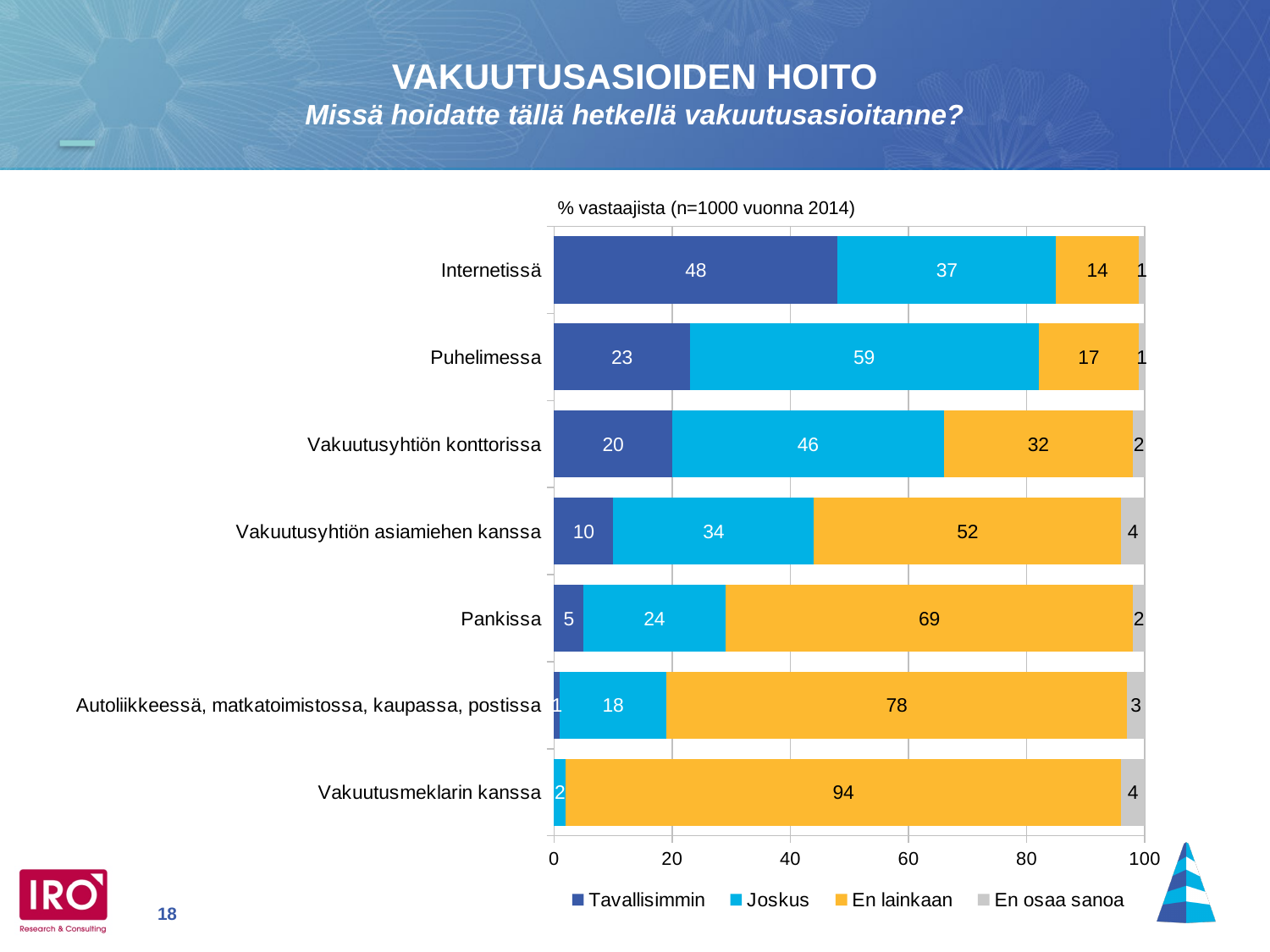
Which category has the highest Tavallisimmin value? Internetissä Which is larger: the Joskus value for Vakuutusyhtiön konttorissa or the Joskus value for Pankissa? Vakuutusyhtiön konttorissa What is the En lainkaan value for Vakuutusmeklarin kanssa? 94 What is the En osaa sanoa value for Vakuutusyhtiön asiamiehen kanssa? 4 Which category has the lowest En lainkaan value? Internetissä What type of chart is shown on the slide? stacked bar chart How many categories are shown on the chart? 7 What is the total of the stacked bar for Puhelimessa? 100 How many series does the legend list? 4 What is the Joskus value for Puhelimessa? 59 What is the Tavallisimmin value for Internetissä? 48 What is the difference between the En lainkaan values for Pankissa and Vakuutusyhtiön konttorissa? 37